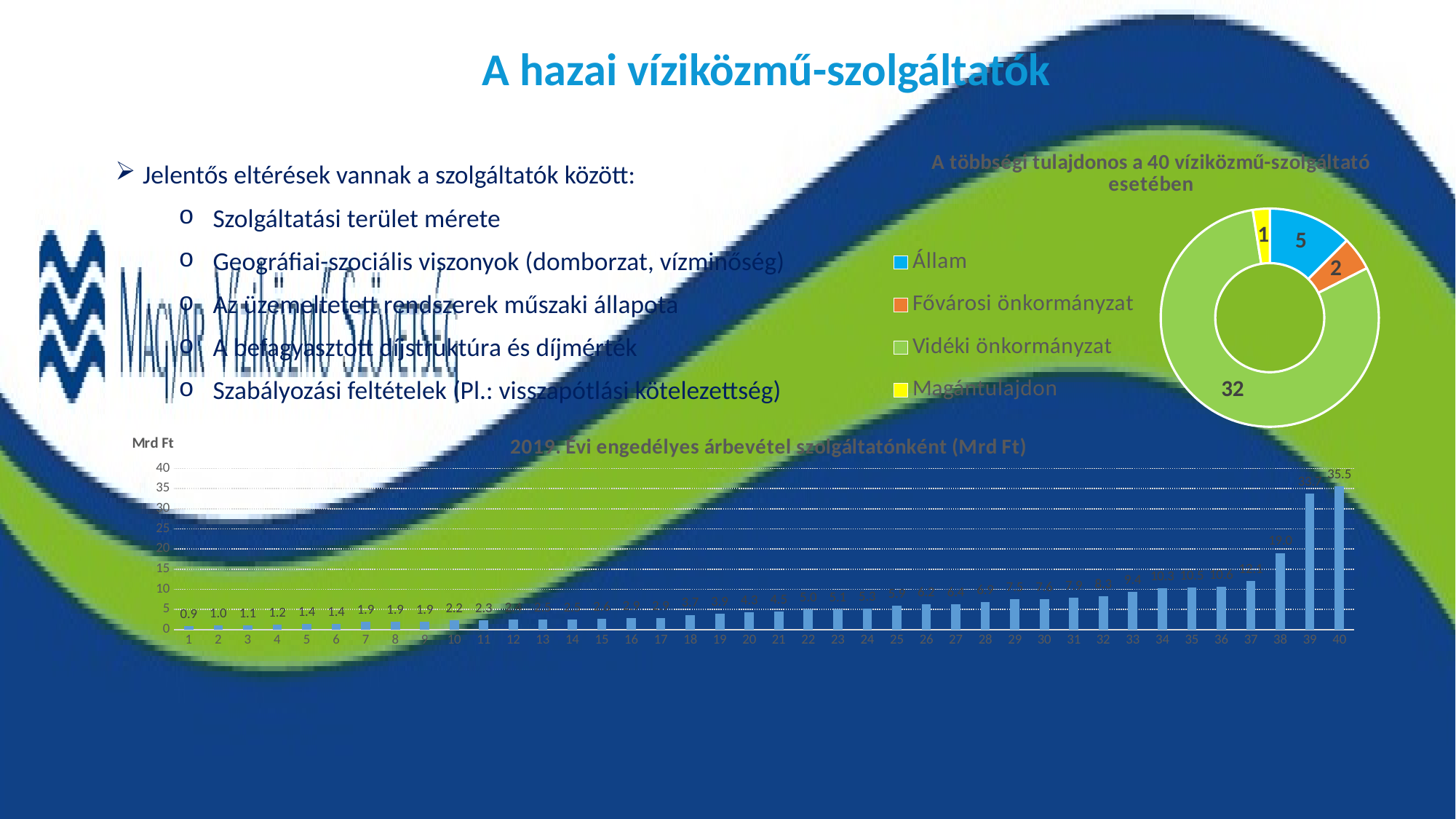
In the doughnut chart 'A többségi tulajdonos a 40 víziközmű-szolgáltató esetében', what share of the 40 providers does Vidéki önkormányzat represent? 80% In the chart '2019. Évi engedélyes árbevétel szolgáltatónként (Mrd Ft)', how many providers (bars) are shown? 40 In the doughnut chart 'A többségi tulajdonos a 40 víziközmű-szolgáltató esetében', what is the difference between the values for Állam and Fővárosi önkormányzat? 3 In the doughnut chart 'A többségi tulajdonos a 40 víziközmű-szolgáltató esetében', how many categories does the legend list? 4 What kind of chart is '2019. Évi engedélyes árbevétel szolgáltatónként (Mrd Ft)'? Bar chart In the doughnut chart 'A többségi tulajdonos a 40 víziközmű-szolgáltató esetében', what is the value for Vidéki önkormányzat? 32 In the chart '2019. Évi engedélyes árbevétel szolgáltatónként (Mrd Ft)', is the value for provider 38 greater or less than 15? greater In the chart '2019. Évi engedélyes árbevétel szolgáltatónként (Mrd Ft)', what is the value for provider 40? 35.5 In the chart '2019. Évi engedélyes árbevétel szolgáltatónként (Mrd Ft)', do the values rise or fall from provider 1 to provider 40? Rise In the doughnut chart 'A többségi tulajdonos a 40 víziközmű-szolgáltató esetében', what is the value for Állam? 5 In the doughnut chart 'A többségi tulajdonos a 40 víziközmű-szolgáltató esetében', which category has the largest value? Vidéki önkormányzat In the doughnut chart 'A többségi tulajdonos a 40 víziközmű-szolgáltató esetében', which category has the smallest value? Magántulajdon